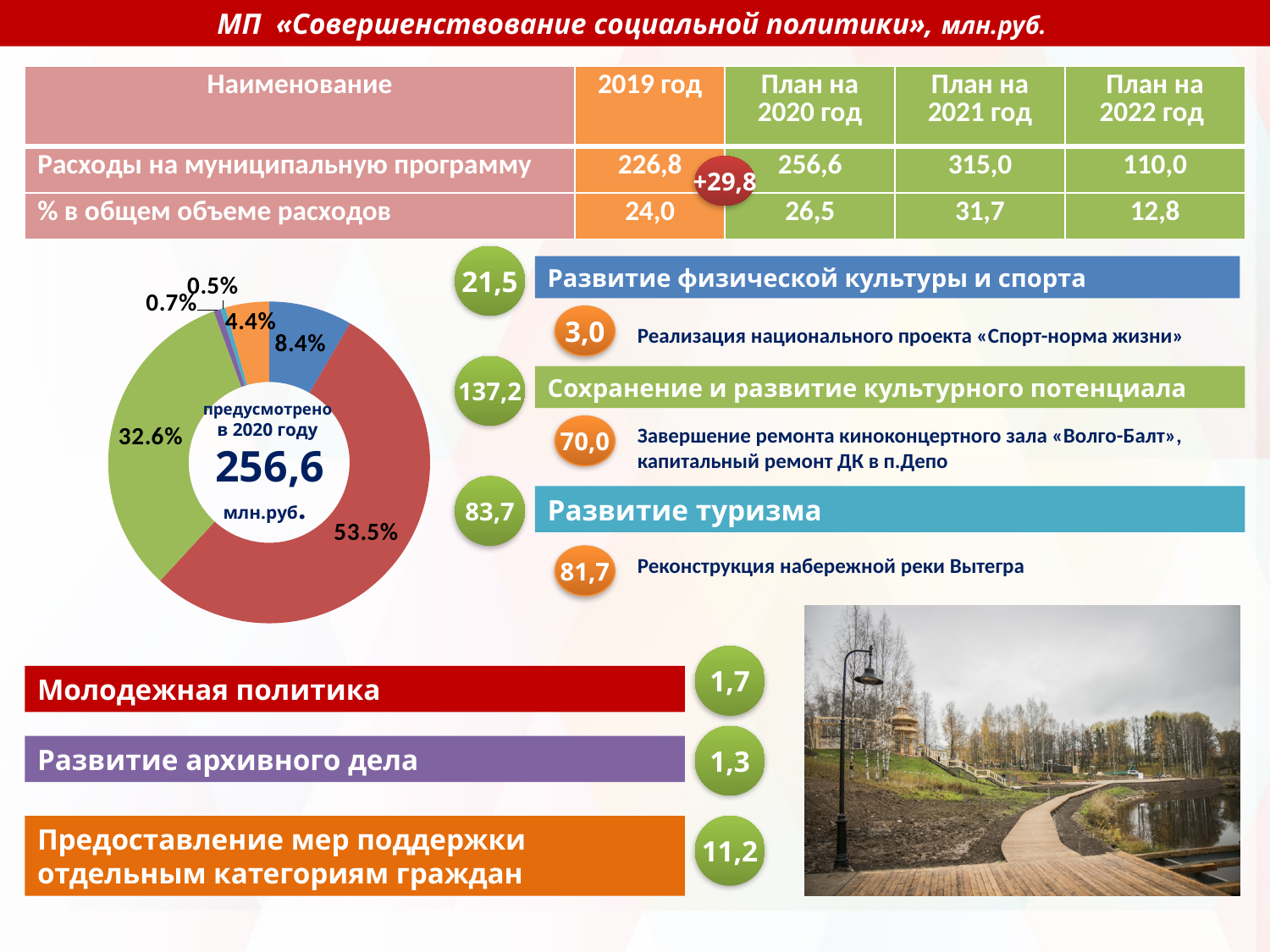
What is the share of the largest slice in the doughnut chart? 53.5% What is the difference in percentage points between the largest slice (53.5%) and the green slice (32.6%) in the doughnut chart? 20.9 What is the share of the orange slice in the doughnut chart? 4.4% What kind of chart is shown on the left of the slide? doughnut (pie) chart Which slice is larger in the doughnut chart: the blue slice or the orange slice? the blue slice (8.4%) Is the share of the red slice in the doughnut chart greater or less than 50%? greater What total amount is printed in the centre of the doughnut chart? 256,6 млн.руб. What is the share of the smallest slice in the doughnut chart? 0.5% What is the share of the blue slice in the doughnut chart? 8.4% How many slices does the doughnut chart have? 6 What is the share of the green slice in the doughnut chart? 32.6% Which year does the text in the centre of the doughnut chart refer to? 2020